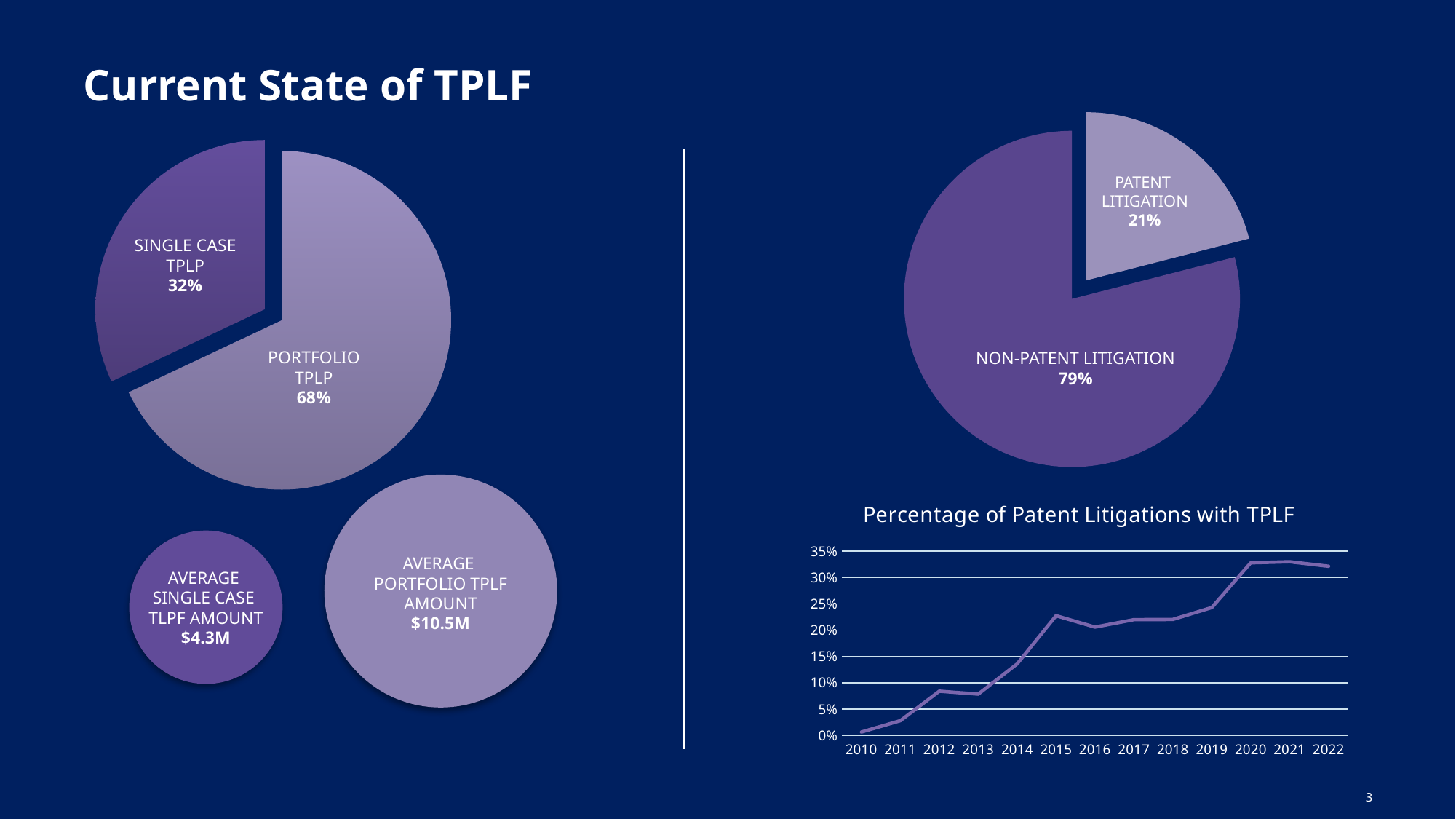
In the left pie chart, what is the difference in percentage points between Portfolio TPLP and Single Case TPLP? 36 In the left pie chart, which slice is larger, Single Case TPLP or Portfolio TPLP? Portfolio TPLP In the 'Percentage of Patent Litigations with TPLF' chart, is the value for 2020 greater or less than 30%? greater In the 'Percentage of Patent Litigations with TPLF' chart, how many years are shown on the x axis? 13 What kind of chart is 'Percentage of Patent Litigations with TPLF'? line chart In the left pie chart, what share is Portfolio TPLP? 68% In the left pie chart, what share is Single Case TPLP? 32% In the top-right pie chart, what share is Patent Litigation? 21% In the 'Percentage of Patent Litigations with TPLF' chart, is the value for 2010 greater or less than 5%? less In the top-right pie chart, which slice is the smallest? Patent Litigation In the top-right pie chart, what share is Non-Patent Litigation? 79% In the 'Percentage of Patent Litigations with TPLF' chart, do values generally rise or fall from 2010 to 2022? rise